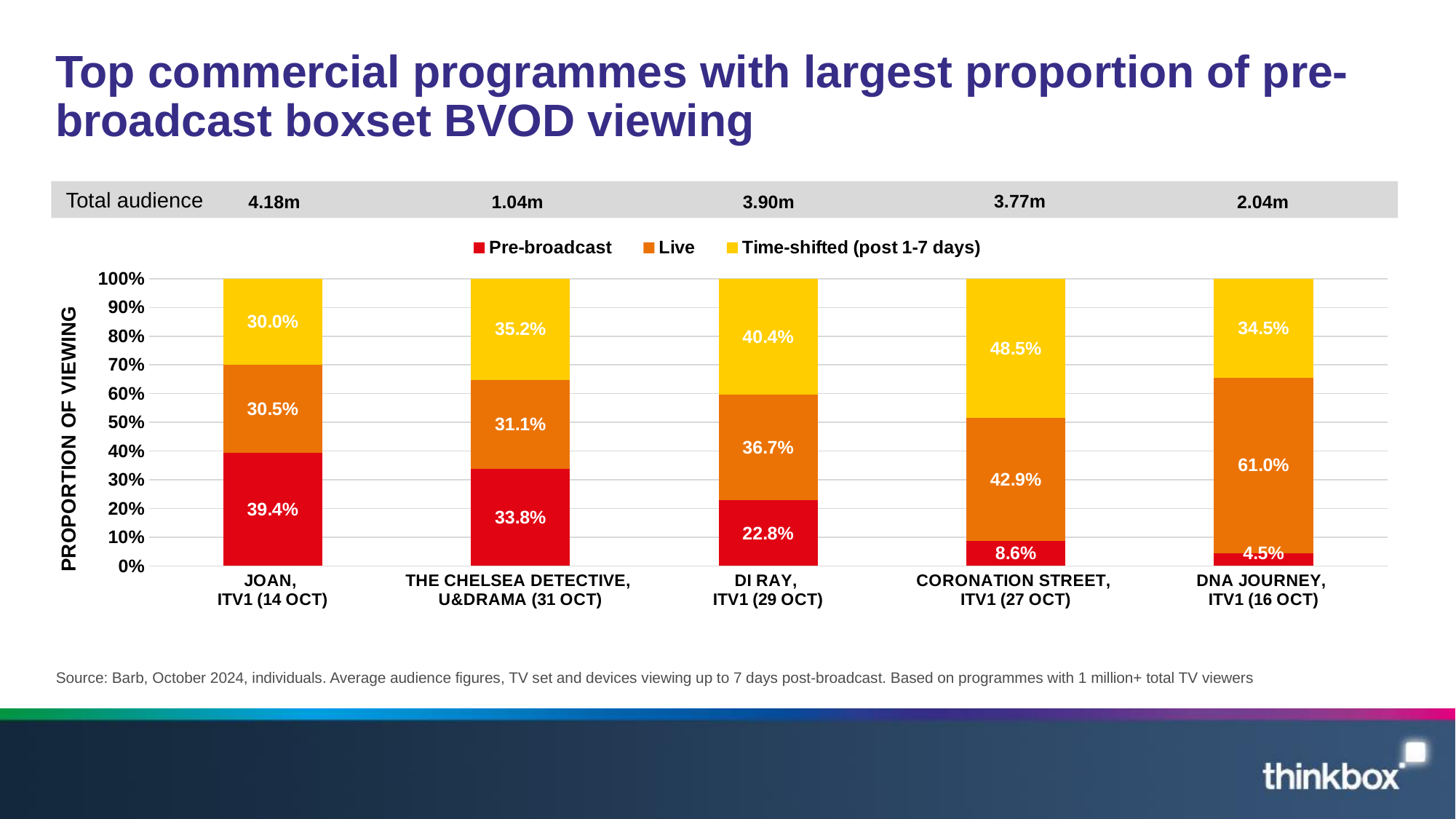
Which is larger: the Time-shifted share for DI Ray or for The Chelsea Detective? DI Ray What is the total audience shown for DI Ray, ITV1 (29 Oct)? 3.90m Which programme has the highest Live share? DNA Journey, ITV1 (16 Oct) How many programmes are shown on the chart? 5 What is the difference between the Pre-broadcast shares of Joan and The Chelsea Detective? 5.6% What kind of chart is shown on the slide? Stacked bar chart Which programme has the lowest Pre-broadcast share? DNA Journey, ITV1 (16 Oct) What is the Pre-broadcast share for Joan, ITV1 (14 Oct)? 39.4% Which programme has the highest Pre-broadcast share? Joan, ITV1 (14 Oct) What is the Live share for DNA Journey, ITV1 (16 Oct)? 61.0% How many series does the legend list? 3 What is the Time-shifted (post 1-7 days) share for Coronation Street, ITV1 (27 Oct)? 48.5%